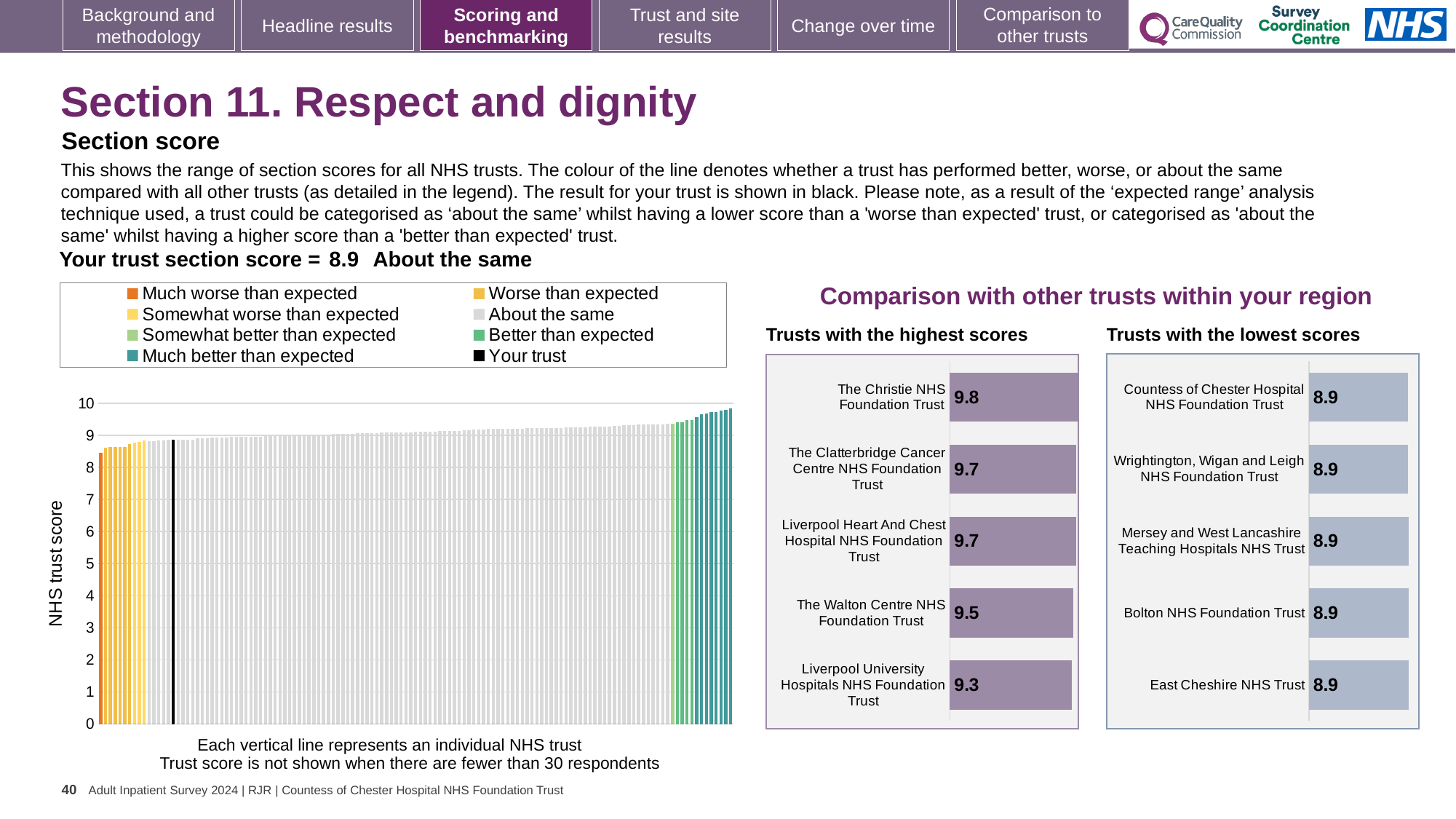
In the NHS trust score chart on the left, do the values rise or fall from left to right? Rise How many entries does the legend of the NHS trust score chart on the left list? 8 In the 'Trusts with the lowest scores' chart, what is the score for Bolton NHS Foundation Trust? 8.9 How many trusts are shown in the 'Trusts with the lowest scores' chart? 5 What kind of chart is the NHS trust score chart on the left of the slide? Bar chart In the 'Trusts with the highest scores' chart, which trust has the highest score? The Christie NHS Foundation Trust In the 'Trusts with the highest scores' chart, what is the score for The Walton Centre NHS Foundation Trust? 9.5 How many trusts are shown in the 'Trusts with the highest scores' chart? 5 In the 'Trusts with the highest scores' chart, what is the score for The Christie NHS Foundation Trust? 9.8 In the 'Trusts with the highest scores' chart, what is the difference between the scores of The Christie NHS Foundation Trust and Liverpool University Hospitals NHS Foundation Trust? 0.5 In the 'Trusts with the highest scores' chart, which has the larger score: The Walton Centre NHS Foundation Trust or Liverpool University Hospitals NHS Foundation Trust? The Walton Centre NHS Foundation Trust In the 'Trusts with the highest scores' chart, which trust has the lowest score? Liverpool University Hospitals NHS Foundation Trust